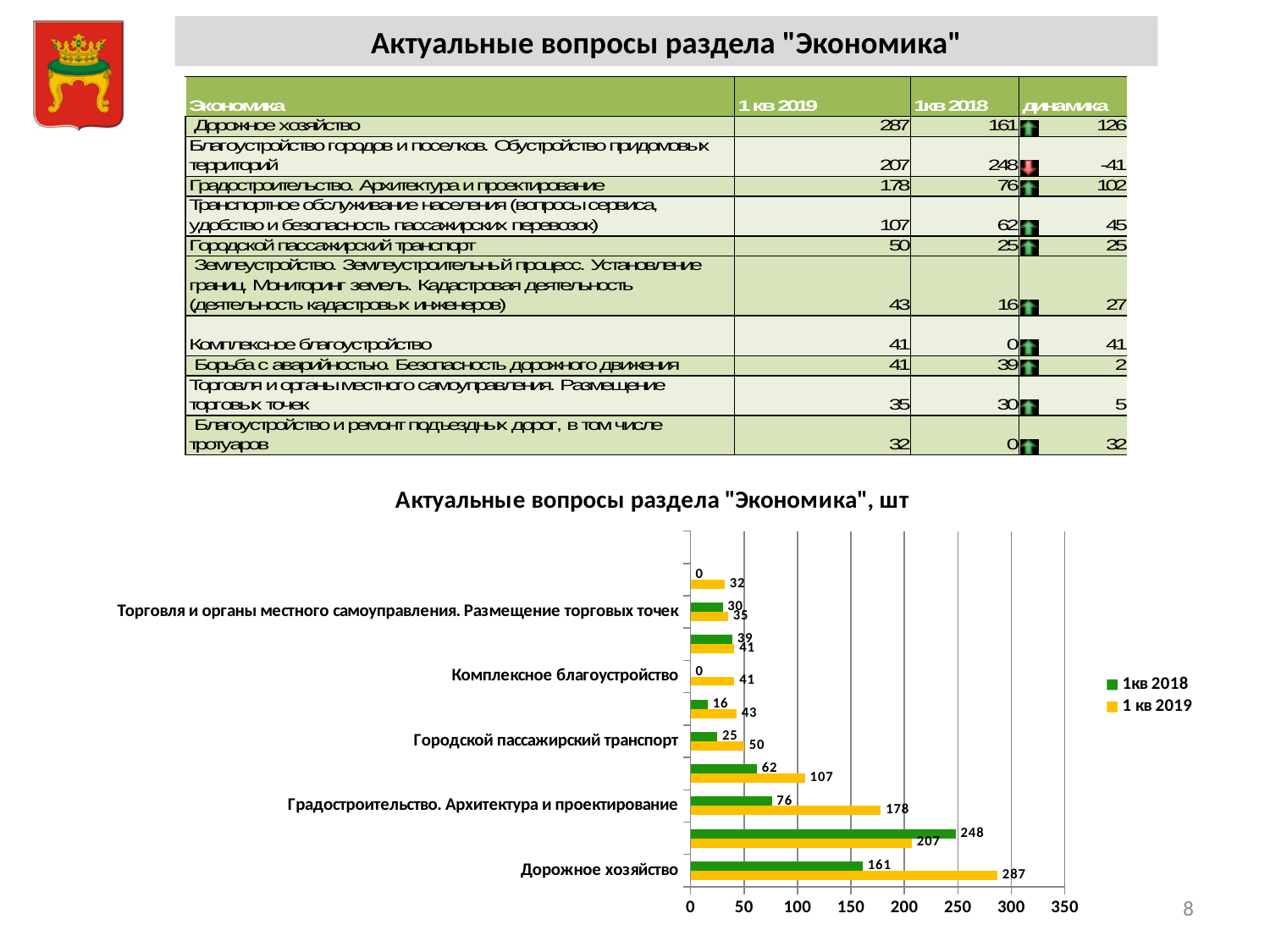
What is the value for Городской пассажирский транспорт in the 1кв 2018 series? 25 What is the value for Дорожное хозяйство in the 1кв 2018 series? 161 Which is larger for Торговля и органы местного самоуправления. Размещение торговых точек: the 1кв 2018 value or the 1 кв 2019 value? 1 кв 2019 What is the value for Комплексное благоустройство in the 1кв 2018 series? 0 How many series does the chart legend list? 2 What kind of chart is shown on the slide? bar chart What is the title of the chart? Актуальные вопросы раздела "Экономика", шт What is the difference between the 1 кв 2019 and 1кв 2018 values for Градостроительство. Архитектура и проектирование? 102 What is the value for Градостроительство. Архитектура и проектирование in the 1 кв 2019 series? 178 What is the difference between the 1 кв 2019 and 1кв 2018 values for Дорожное хозяйство? 126 What is the value for Дорожное хозяйство in the 1 кв 2019 series? 287 Which labelled category has the highest 1 кв 2019 value? Дорожное хозяйство